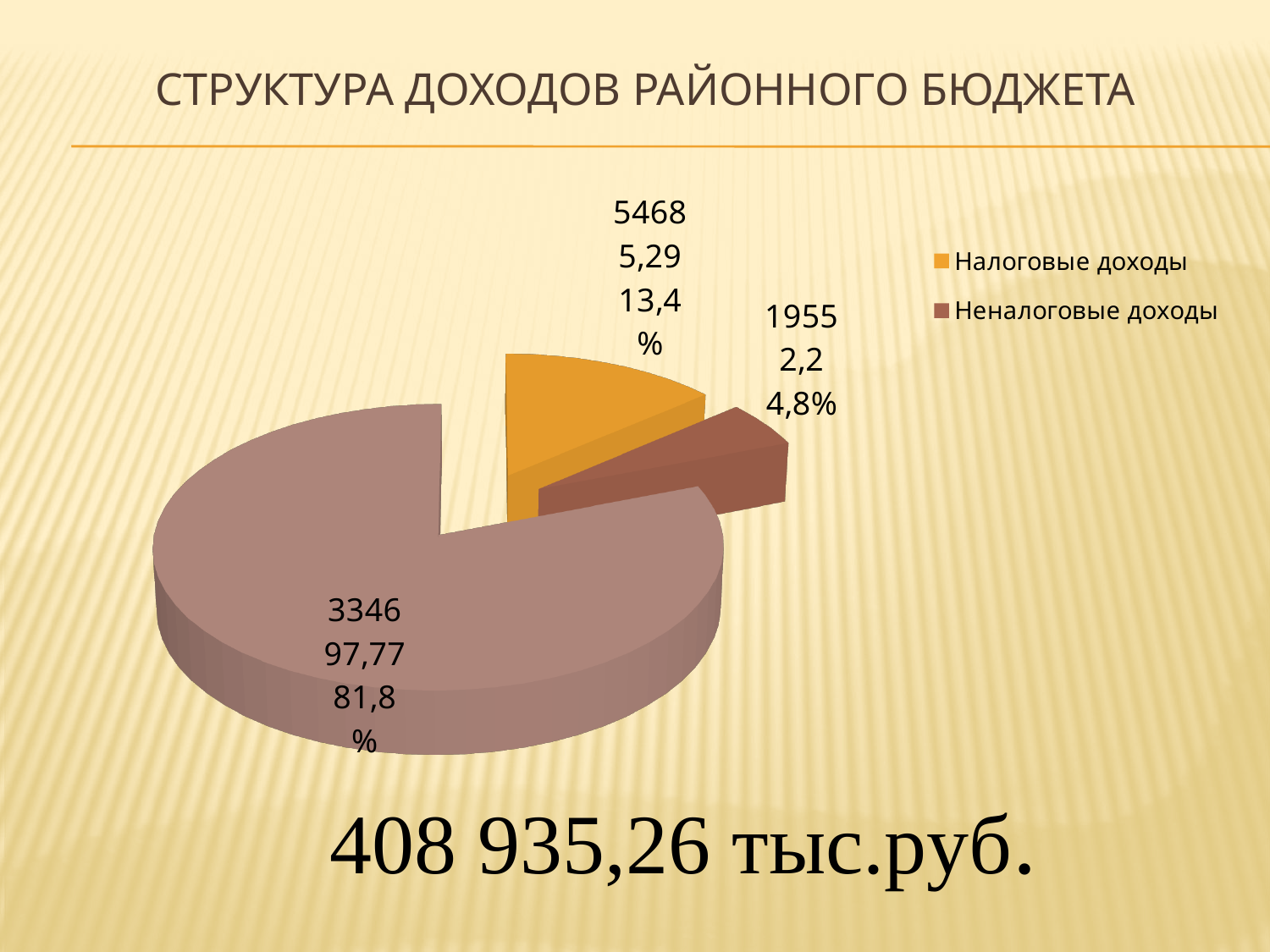
What percentage is labelled on the largest slice of the pie? 81,8% What is the difference in percentage points between the Налоговые доходы share and the Неналоговые доходы share? 8,6 How many entries does the legend list? 2 What share of the pie does Неналоговые доходы represent? 4,8% Which is larger, the share of Налоговые доходы or the share of Неналоговые доходы? Налоговые доходы How many slices does the pie chart have? 3 What share of the pie does Налоговые доходы represent? 13,4% What is the value labelled on the Неналоговые доходы slice? 19552,2 What is the value labelled on the Налоговые доходы slice? 54685,29 What total amount is printed below the chart? 408 935,26 тыс.руб. What kind of chart is shown on the slide? pie chart What is the title of the chart on the slide? СТРУКТУРА ДОХОДОВ РАЙОННОГО БЮДЖЕТА